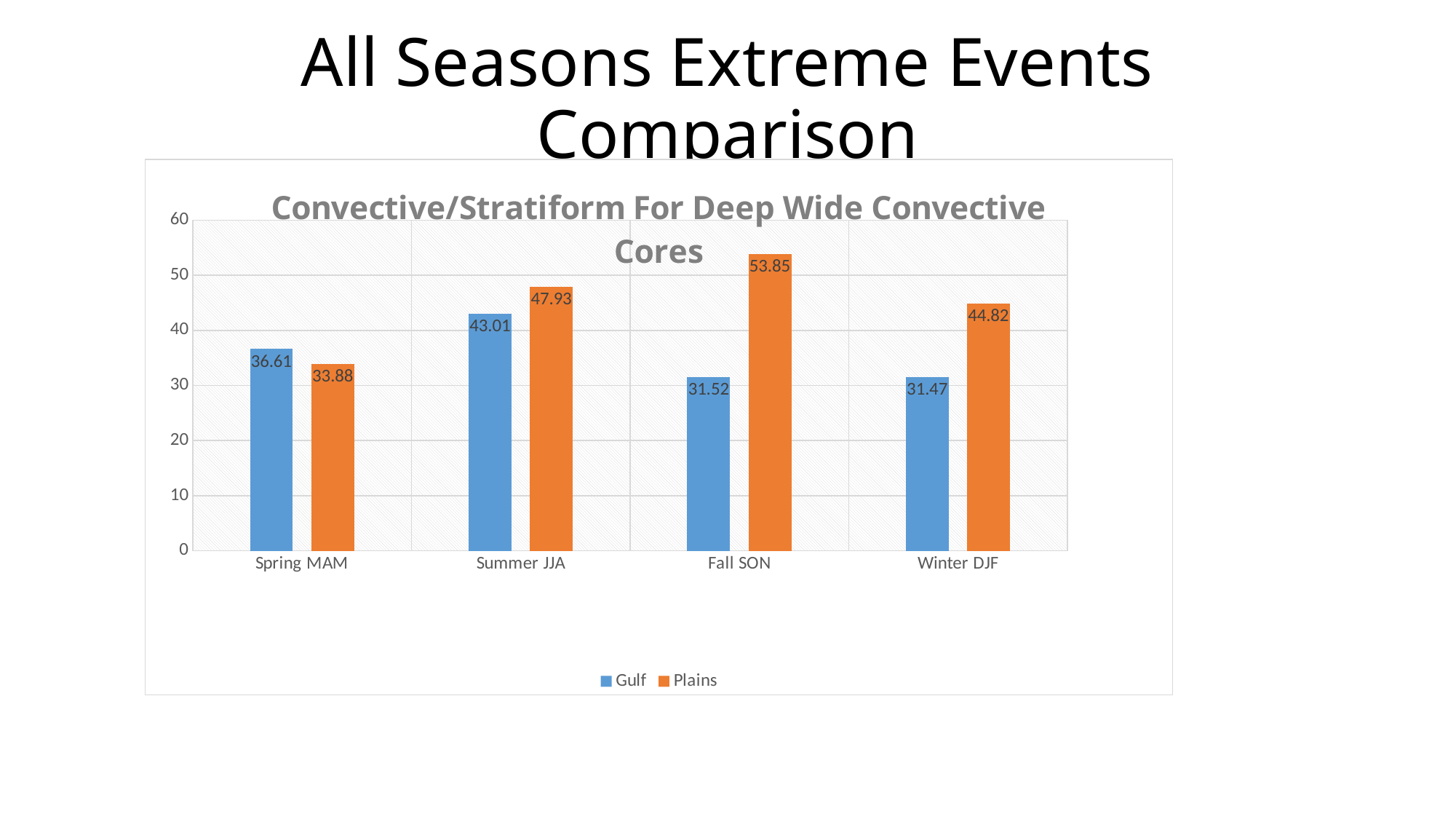
Which season has the lowest Plains value? Spring MAM For Spring MAM, which is larger, the Gulf value or the Plains value? Gulf Which season has the highest Gulf value? Summer JJA What is the Gulf value for Spring MAM? 36.61 How many series does the legend list? 2 What is the difference between the Plains and Gulf values for Fall SON? 22.33 How many seasons are shown on the x axis? 4 What type of chart is shown on the slide? Bar chart What is the Plains value for Summer JJA? 47.93 What is the Gulf value for Winter DJF? 31.47 Which season has the highest Plains value? Fall SON What is the Plains value for Fall SON? 53.85